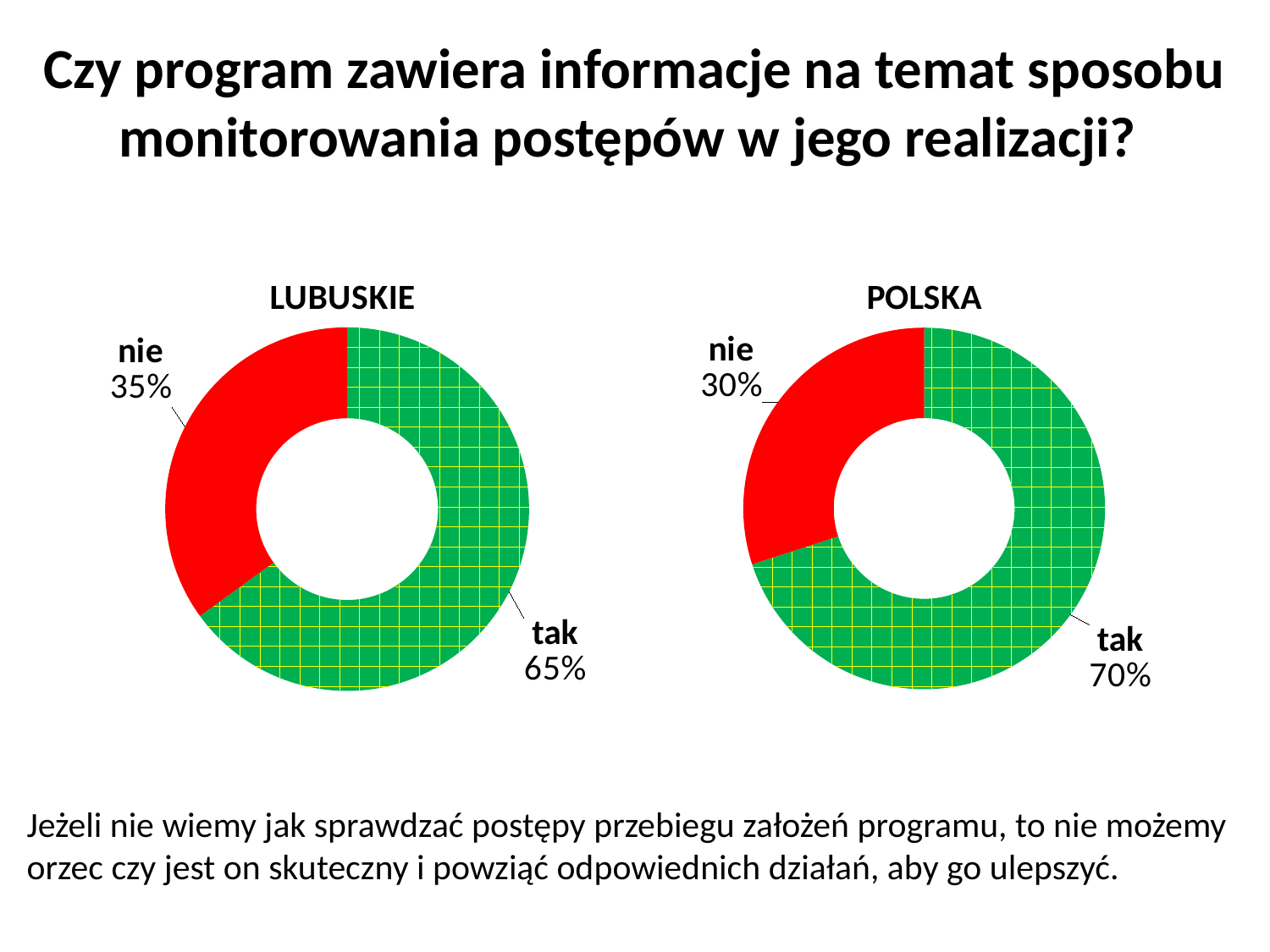
In the POLSKA chart, which category has the smallest share? nie In the POLSKA chart, what colour is the "nie" slice? Red What kind of chart is the LUBUSKIE chart? Doughnut chart In the POLSKA chart, what is the value for "tak"? 70% How many categories does the POLSKA chart show? 2 In the LUBUSKIE chart, which category has the largest share? tak Is the "tak" share larger in the LUBUSKIE chart or the POLSKA chart? POLSKA In the LUBUSKIE chart, what is the value for "nie"? 35% What is the title of the chart on the right? POLSKA In the POLSKA chart, what is the value for "nie"? 30% In the LUBUSKIE chart, what is the difference between "tak" and "nie"? 30% In the LUBUSKIE chart, what is the value for "tak"? 65%